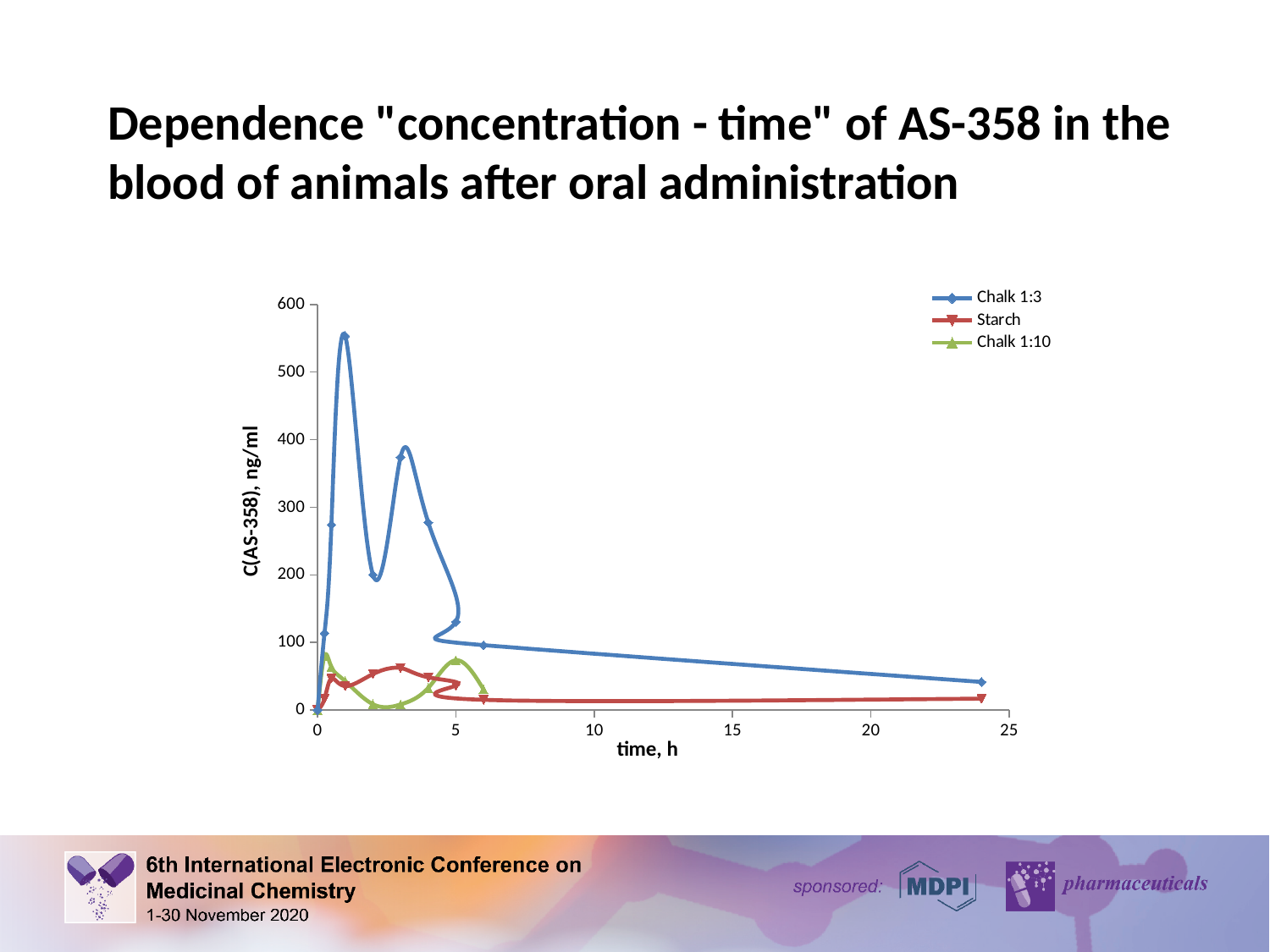
What kind of chart is shown on the slide? line chart Which series has the larger value at 1 h, Chalk 1:3 or Starch? Chalk 1:3 Which series are listed in the legend? Chalk 1:3, Starch, Chalk 1:10 Is the value for Chalk 1:3 at 24 h greater or less than 100? less Is the highest value for Chalk 1:10 greater or less than 100? less What is the label of the y axis? C(AS-358), ng/ml Does the Chalk 1:3 concentration rise or fall between 6 h and 24 h? fall Is the highest value for Starch greater or less than 100? less How many series does the legend list? 3 Which series reaches the highest concentration of AS-358? Chalk 1:3